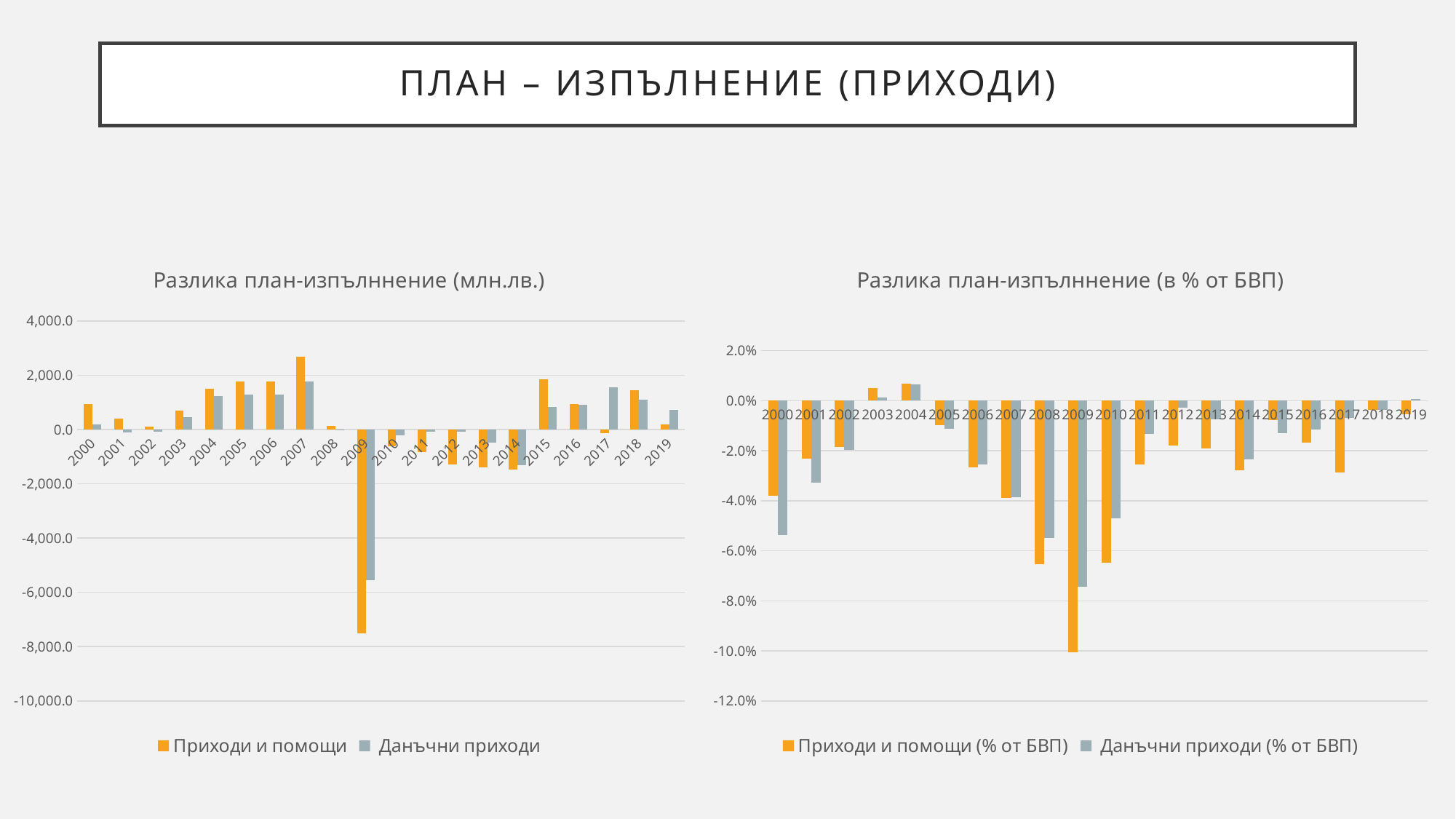
How many series does the legend of the right chart "Разлика план-изпълннение (в % от БВП)" list? 2 In the left chart "Разлика план-изпълннение (млн.лв.)", is the value for Приходи и помощи in 2009 greater or less than -6,000.0? less In the left chart "Разлика план-изпълннение (млн.лв.)", is the value for Приходи и помощи in 2007 greater or less than 2,000.0? greater How many years are shown on the x axis of the left chart "Разлика план-изпълннение (млн.лв.)"? 20 What kind of chart is the left chart titled "Разлика план-изпълннение (млн.лв.)"? bar chart In the left chart "Разлика план-изпълннение (млн.лв.)", which year has the lowest value for Приходи и помощи? 2009 In the left chart "Разлика план-изпълннение (млн.лв.)", which year has the highest value for Приходи и помощи? 2007 In the right chart "Разлика план-изпълннение (в % от БВП)", is the value for Приходи и помощи (% от БВП) in 2009 greater or less than -8.0%? less In the left chart "Разлика план-изпълннение (млн.лв.)", which series has the larger value in 2009, Приходи и помощи or Данъчни приходи? Данъчни приходи In the right chart "Разлика план-изпълннение (в % от БВП)", which year has the highest value for Данъчни приходи (% от БВП)? 2004 In the right chart "Разлика план-изпълннение (в % от БВП)", which year has the lowest value for Приходи и помощи (% от БВП)? 2009